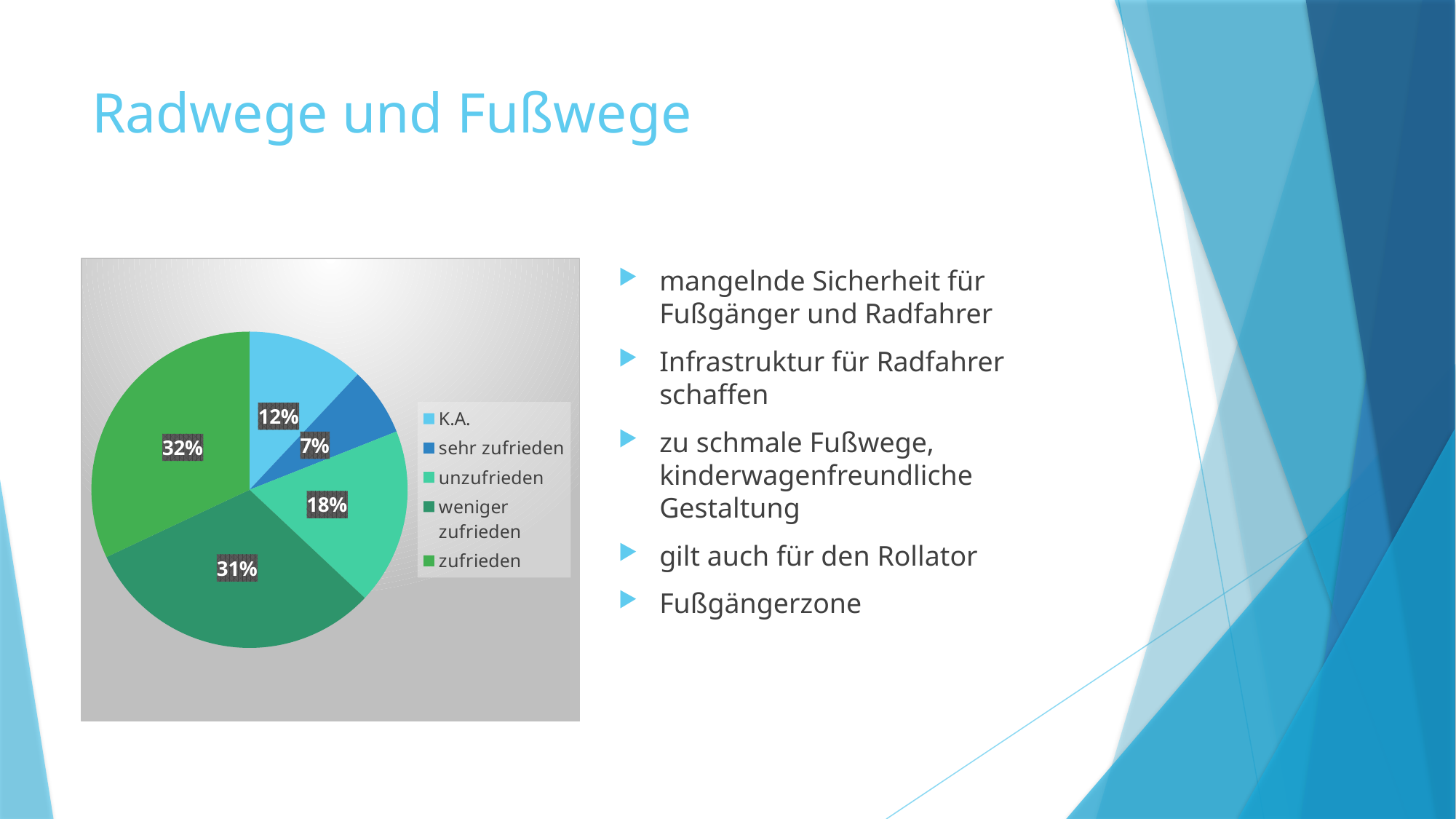
What percentage does the "sehr zufrieden" slice represent in the pie chart? 7% What share of the pie does the "zufrieden" slice take? 32% Which is larger, the "K.A." slice or the "unzufrieden" slice? unzufrieden How many slices does the pie chart have? 5 What is the difference in percentage points between "unzufrieden" and "sehr zufrieden"? 11 Which category has the smallest slice in the pie chart? sehr zufrieden How many entries does the legend of the pie chart list? 5 What percentage does the "unzufrieden" slice represent in the pie chart? 18% What percentage does the "weniger zufrieden" slice represent in the pie chart? 31% What type of chart is shown on the slide? pie chart Which category has the largest slice in the pie chart? zufrieden What percentage does the "K.A." slice represent in the pie chart? 12%